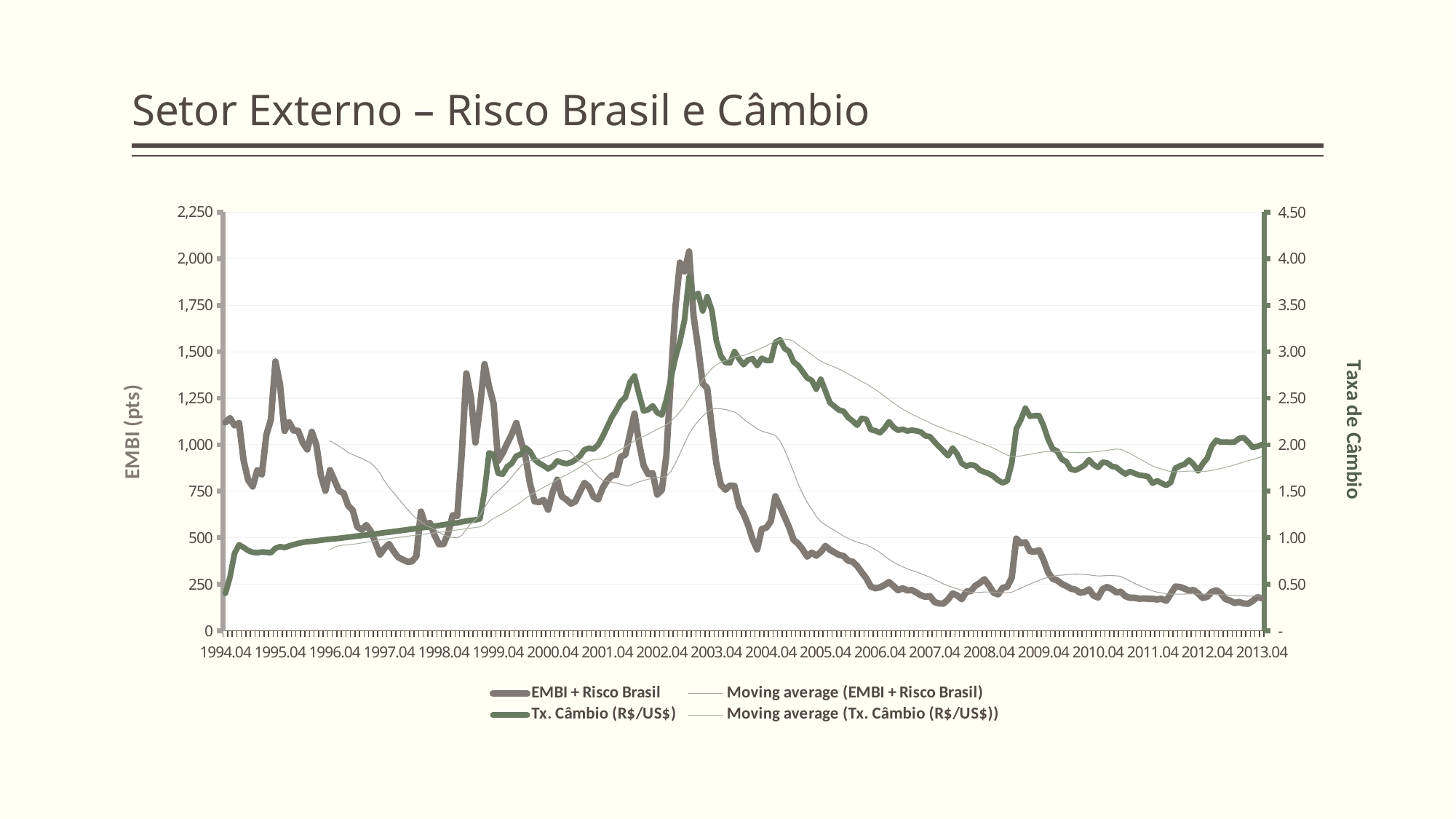
Does the EMBI + Risco Brasil series rise or fall between 2003.04 and 2007.04? fall Is the EMBI + Risco Brasil value at 1994.04 greater or less than 1,000? greater How many date labels are shown along the x axis? 20 How many series does the legend list? 4 What kind of chart is shown on the slide? line chart Is the Tx. Câmbio (R$/US$) value at 1994.04 greater or less than 0.50? less What is the label of the right-hand vertical axis? Taxa de Câmbio Which is larger for the Tx. Câmbio (R$/US$) series: the value at 1994.04 or the value at 2013.04? 2013.04 Is the peak value of the Tx. Câmbio (R$/US$) series greater or less than 3.50? greater What is the title of the slide? Setor Externo – Risco Brasil e Câmbio